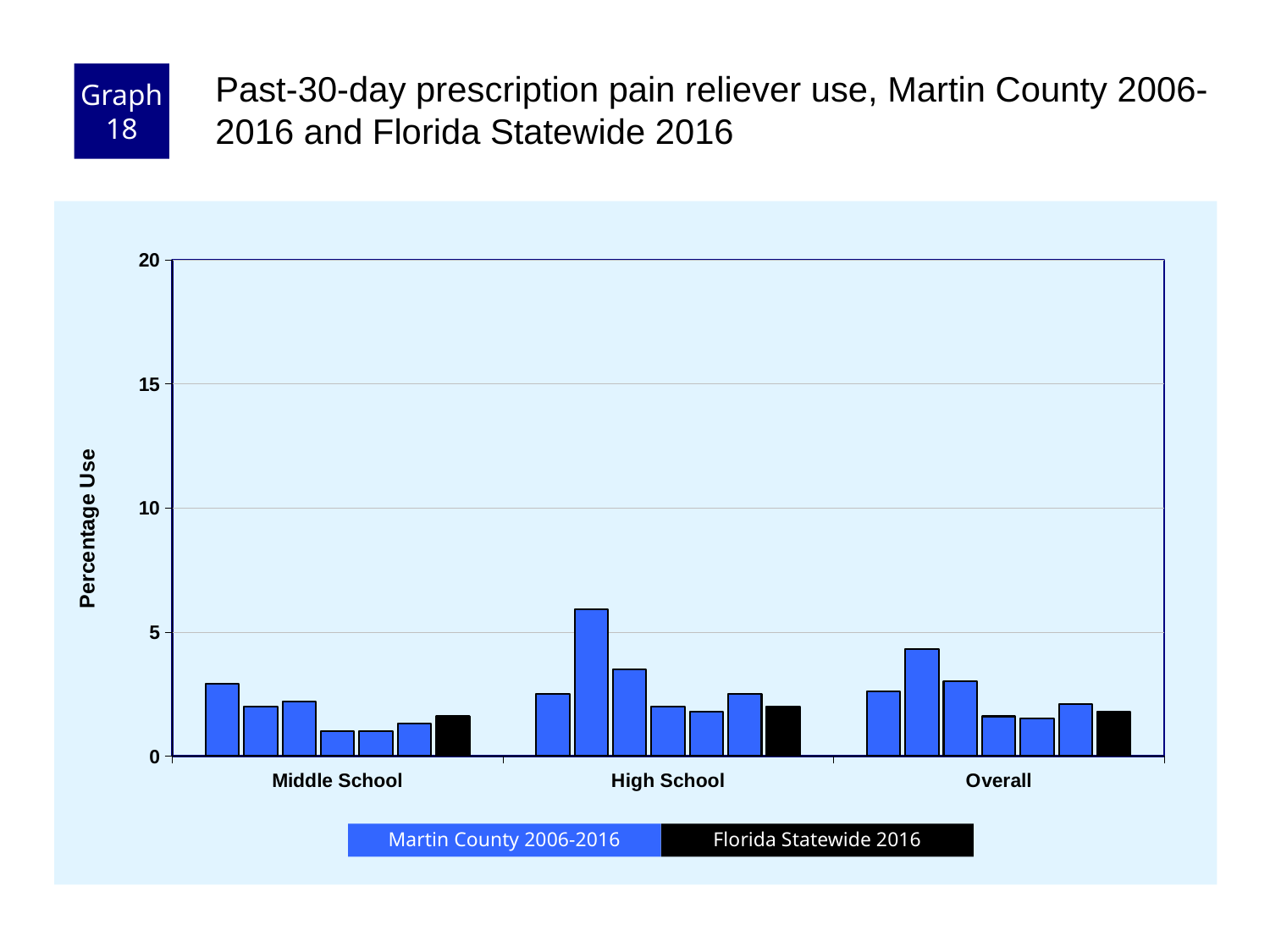
What colour represents Florida Statewide 2016 in the legend? black Is the tallest Martin County bar in the Overall group greater or less than 5? less What is the label on the y axis? Percentage Use What kind of chart is shown on the slide? bar chart Is the Florida Statewide 2016 value for High School greater or less than 5? less Is the tallest Martin County bar in the High School group greater or less than 5? greater Which category group contains the tallest bar on the chart? High School How many series does the legend list? 2 How many category groups are shown along the x axis? 3 Is the Florida Statewide 2016 bar larger for High School or for Middle School? High School